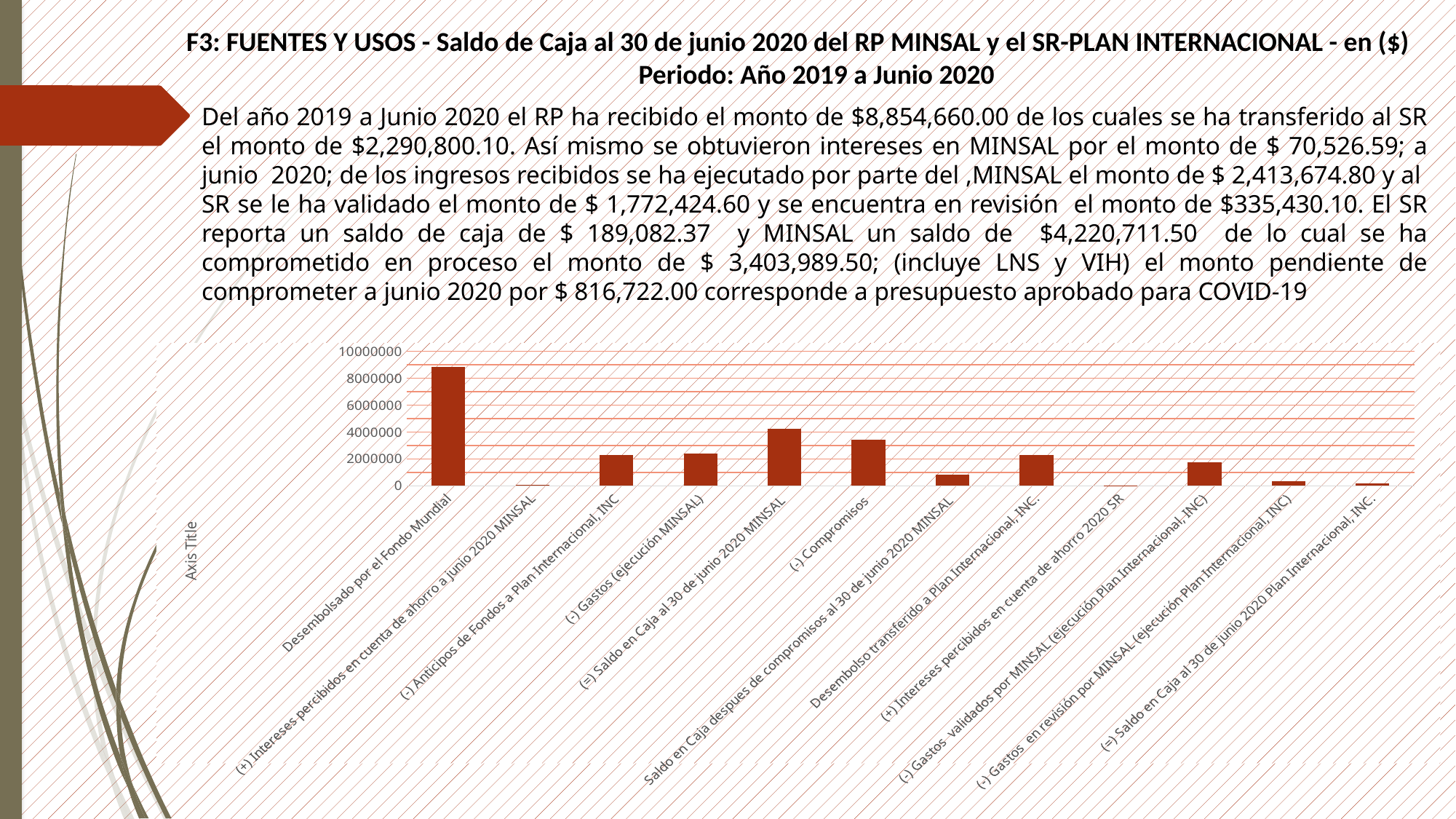
Which category has the highest bar in the chart? Desembolsado por el Fondo Mundial Is the value for "Desembolsado por el Fondo Mundial" greater or less than 8000000? greater Is the value for "(-) Compromisos" greater or less than 2000000? greater Which is larger: the bar for "(=) Saldo en Caja al 30 de junio 2020 MINSAL" or the bar for "(-) Compromisos"? (=) Saldo en Caja al 30 de junio 2020 MINSAL Is the value for "(-) Gastos en revisión por MINSAL (ejecución Plan Internacional, INC)" greater or less than 2000000? less Which is larger: the bar for "(-) Compromisos" or the bar for "Saldo en Caja despues de compromisos al 30 de junio 2020 MINSAL"? (-) Compromisos What kind of chart is shown on the slide? bar chart How many categories (bars) does the chart show? 12 What is the highest tick value shown on the chart's vertical axis? 10000000